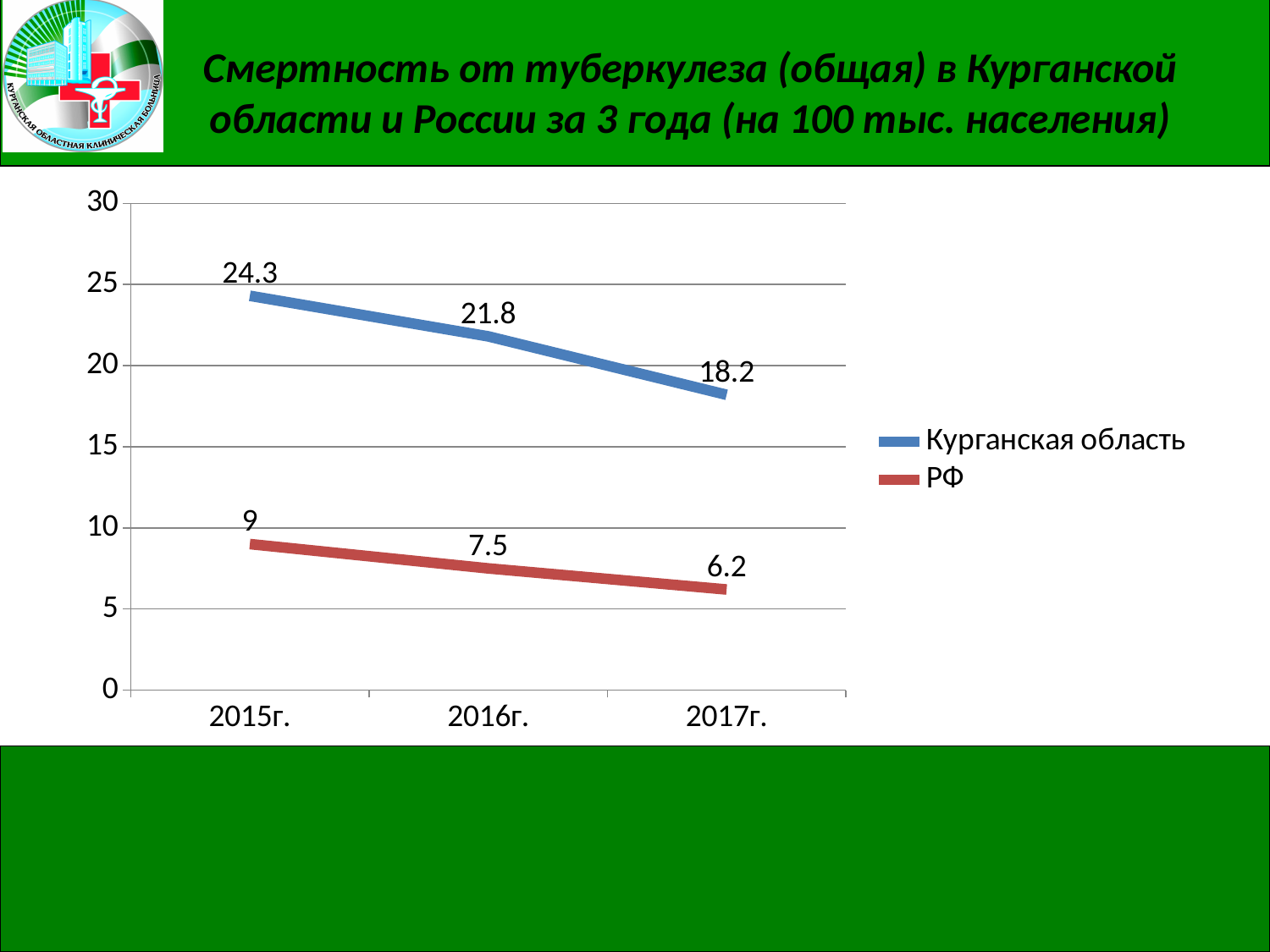
In which year is the value for Курганская область highest? 2015г. How many series does the legend list? 2 What is the value for Курганская область in 2016г.? 21.8 Is the value for Курганская область in 2017г. greater or less than 20? less In which year is the value for РФ lowest? 2017г. What is the difference between the Курганская область and РФ values in 2017г.? 12 What is the value for РФ in 2017г.? 6.2 What is the value for РФ in 2015г.? 9 What is the value for Курганская область in 2015г.? 24.3 Do the values for РФ rise or fall from 2015г. to 2017г.? fall How many years are shown on the x axis? 3 Which is larger in 2016г., the value for Курганская область or for РФ? Курганская область